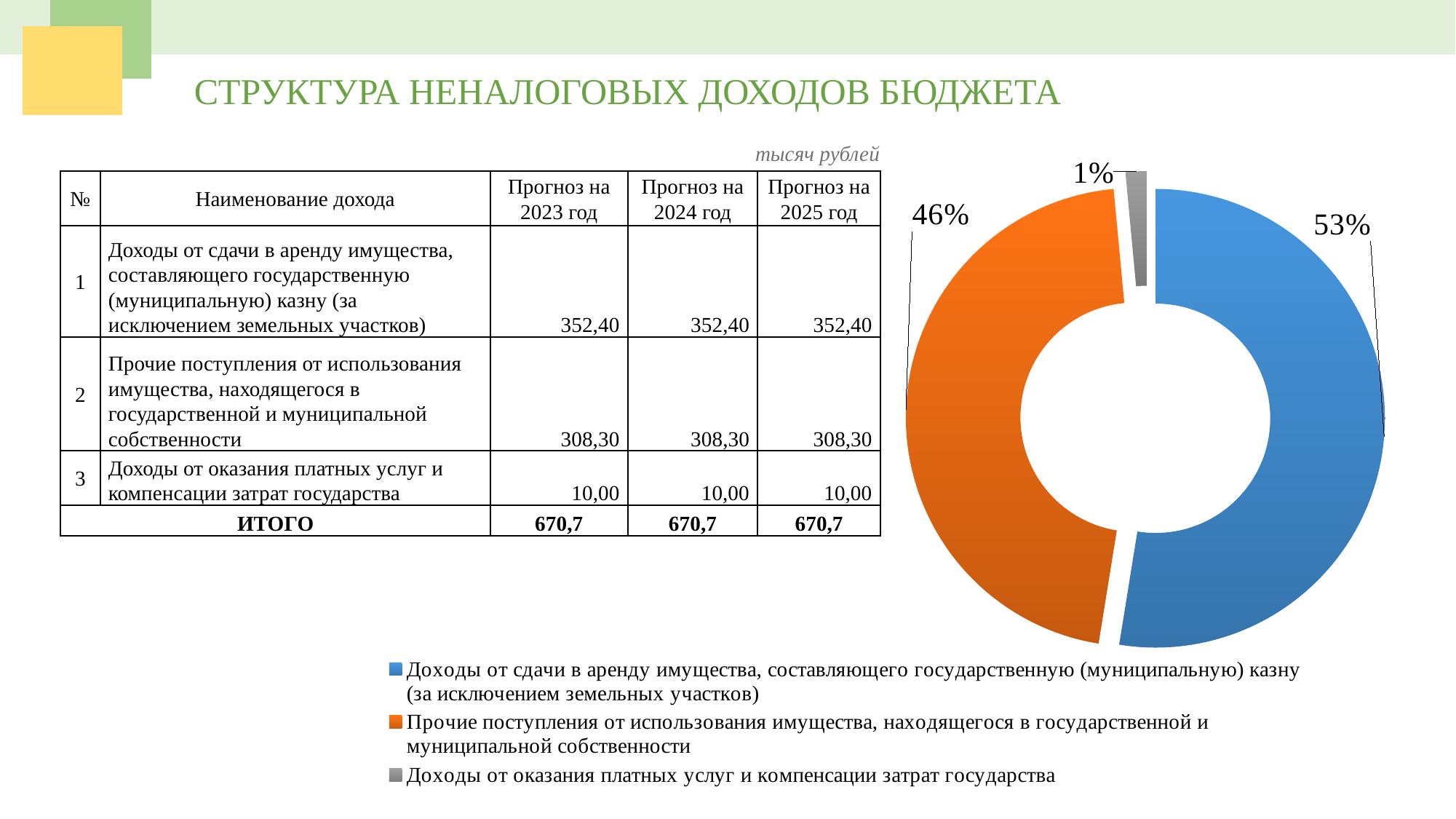
By how many percentage points does the orange slice (46%) exceed the grey slice (1%)? 45 percentage points What share of the doughnut chart is taken by 'Прочие поступления от использования имущества, находящегося в государственной и муниципальной собственности'? 46% What type of chart is shown on the slide? Doughnut (pie) chart Which category has the smallest slice in the doughnut chart? Доходы от оказания платных услуг и компенсации затрат государства How many categories (slices) does the doughnut chart show? 3 Which slice is larger: the one for rental income from state (municipal) treasury property or the one for other income from use of state and municipal property? Rental income from state (municipal) treasury property (53%) By how many percentage points does the blue slice (53%) exceed the orange slice (46%)? 7 percentage points What share of the doughnut chart is taken by 'Доходы от сдачи в аренду имущества, составляющего государственную (муниципальную) казну (за исключением земельных участков)'? 53% What colour is the slice for 'Доходы от оказания платных услуг и компенсации затрат государства'? Grey Which category has the largest slice in the doughnut chart? Доходы от сдачи в аренду имущества, составляющего государственную (муниципальную) казну (за исключением земельных участков) What share of the doughnut chart is taken by 'Доходы от оказания платных услуг и компенсации затрат государства'? 1% How many entries does the chart legend list? 3